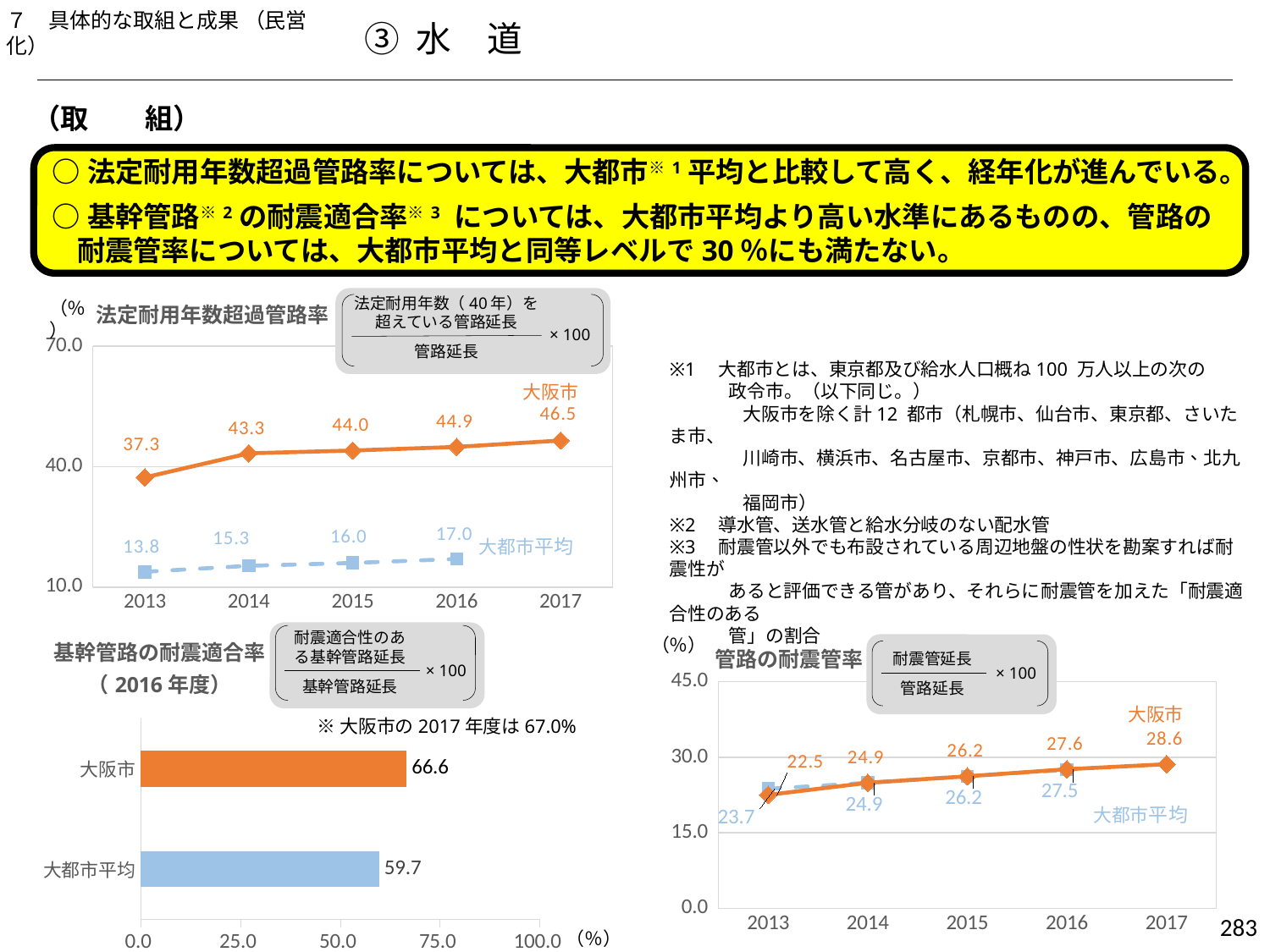
In the 法定耐用年数超過管路率 chart, what is the value for 大阪市 in 2017? 46.5 In the 法定耐用年数超過管路率 chart, what is the difference between 大阪市 and 大都市平均 in 2016? 27.9 In the 基幹管路の耐震適合率（2016年度） chart, what is the difference between 大阪市 and 大都市平均? 6.9 In the 法定耐用年数超過管路率 chart, do the 大阪市 values rise or fall from 2013 to 2017? rise In the 管路の耐震管率 chart, is the value for 大阪市 in 2017 greater or less than 30.0? less In the 管路の耐震管率 chart, what is the value for 大都市平均 in 2016? 27.5 In the 法定耐用年数超過管路率 chart, what is the value for 大都市平均 in 2013? 13.8 In the 管路の耐震管率 chart, what is the value for 大阪市 in 2017? 28.6 In the 管路の耐震管率 chart, which year has the lowest value for 大阪市? 2013 In the 法定耐用年数超過管路率 chart, how many years are shown on the x axis? 5 In the 基幹管路の耐震適合率（2016年度） chart, what is the value for 大阪市? 66.6 What kind of chart is the 基幹管路の耐震適合率（2016年度） chart? bar chart